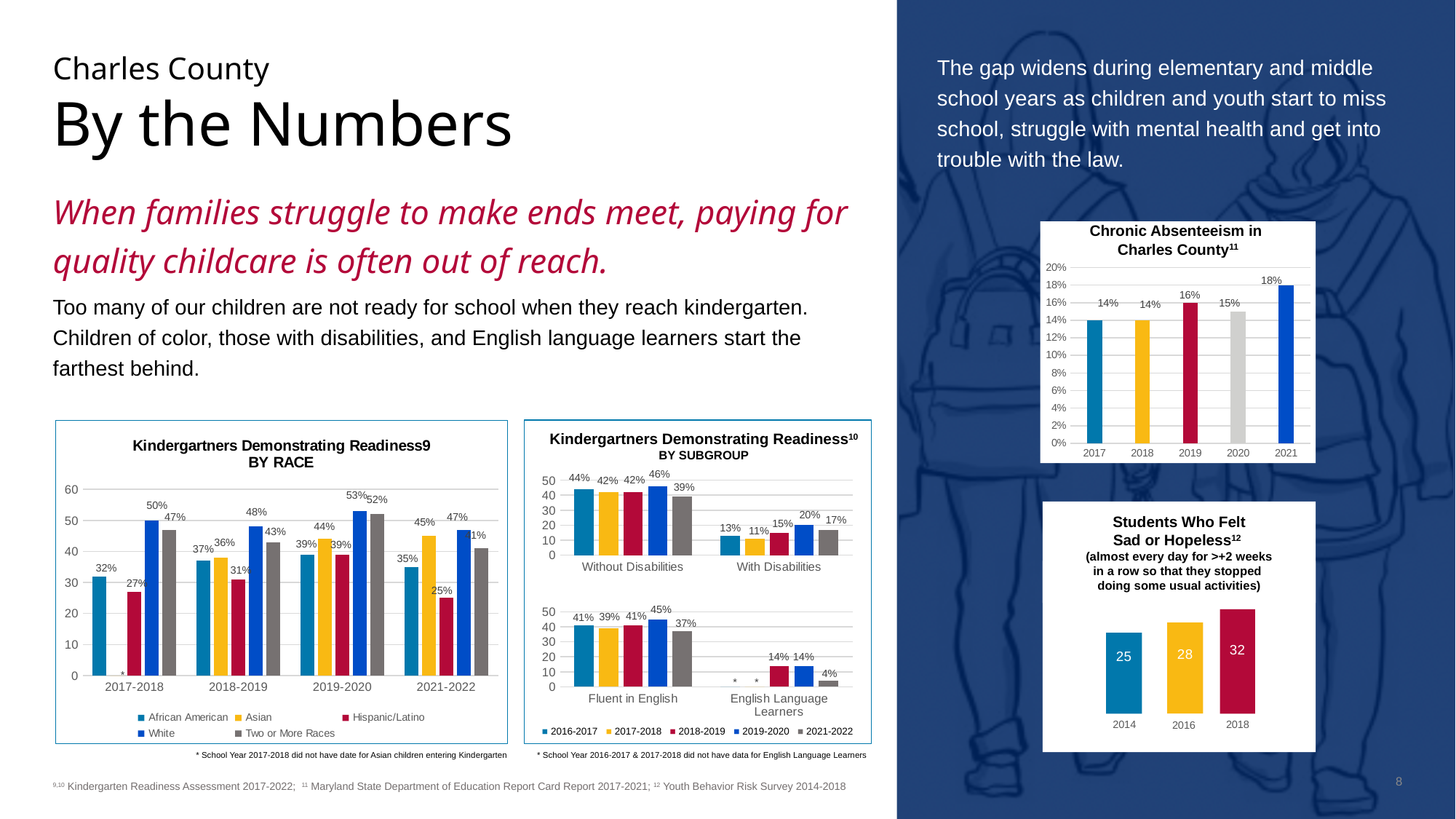
In the Chronic Absenteeism in Charles County chart, which year has the highest value? 2021 In the Students Who Felt Sad or Hopeless chart, how many years are shown? 3 In the Kindergartners Demonstrating Readiness BY RACE chart, which group has the lowest value in 2021-2022? Hispanic/Latino In the Kindergartners Demonstrating Readiness BY RACE chart, what is the value for White in 2019-2020? 53% In the Kindergartners Demonstrating Readiness BY SUBGROUP chart, which is larger for 2021-2022: Fluent in English or English Language Learners? Fluent in English In the Kindergartners Demonstrating Readiness BY RACE chart, how many series does the legend list? 5 What kind of chart is the Chronic Absenteeism in Charles County chart? bar chart In the Kindergartners Demonstrating Readiness BY SUBGROUP chart, what is the value for With Disabilities in 2019-2020? 20% In the Chronic Absenteeism in Charles County chart, what is the value for 2021? 18% In the Students Who Felt Sad or Hopeless chart, what is the value for 2016? 28 In the Chronic Absenteeism in Charles County chart, what is the difference between the 2021 and 2017 values? 4% In the Students Who Felt Sad or Hopeless chart, do the values rise or fall from 2014 to 2018? rise